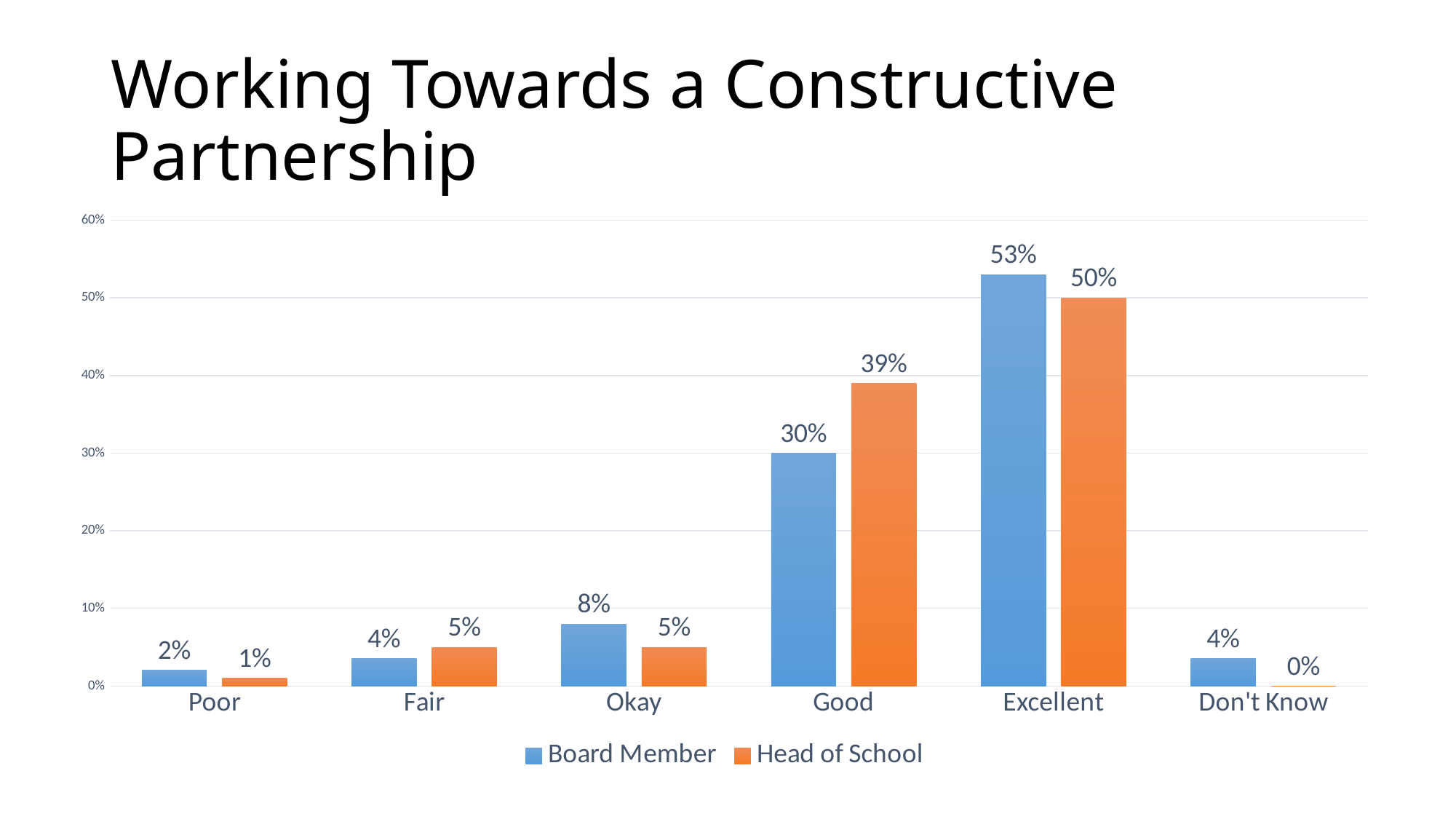
What is the difference between the Head of School and Board Member values for Good? 9% Is the Head of School value for Good greater or less than 40%? less What is the Board Member value for Good? 30% Which category has the lowest Head of School value? Don't Know Which category has the highest Board Member value? Excellent What is the Head of School value for Excellent? 50% How many categories are shown on the x axis? 6 What is the Head of School value for Don't Know? 0% How many series does the legend list? 2 What kind of chart is shown on the slide? Bar chart Which colour represents Head of School in the chart? Orange Which is larger for Okay: the Board Member value or the Head of School value? Board Member